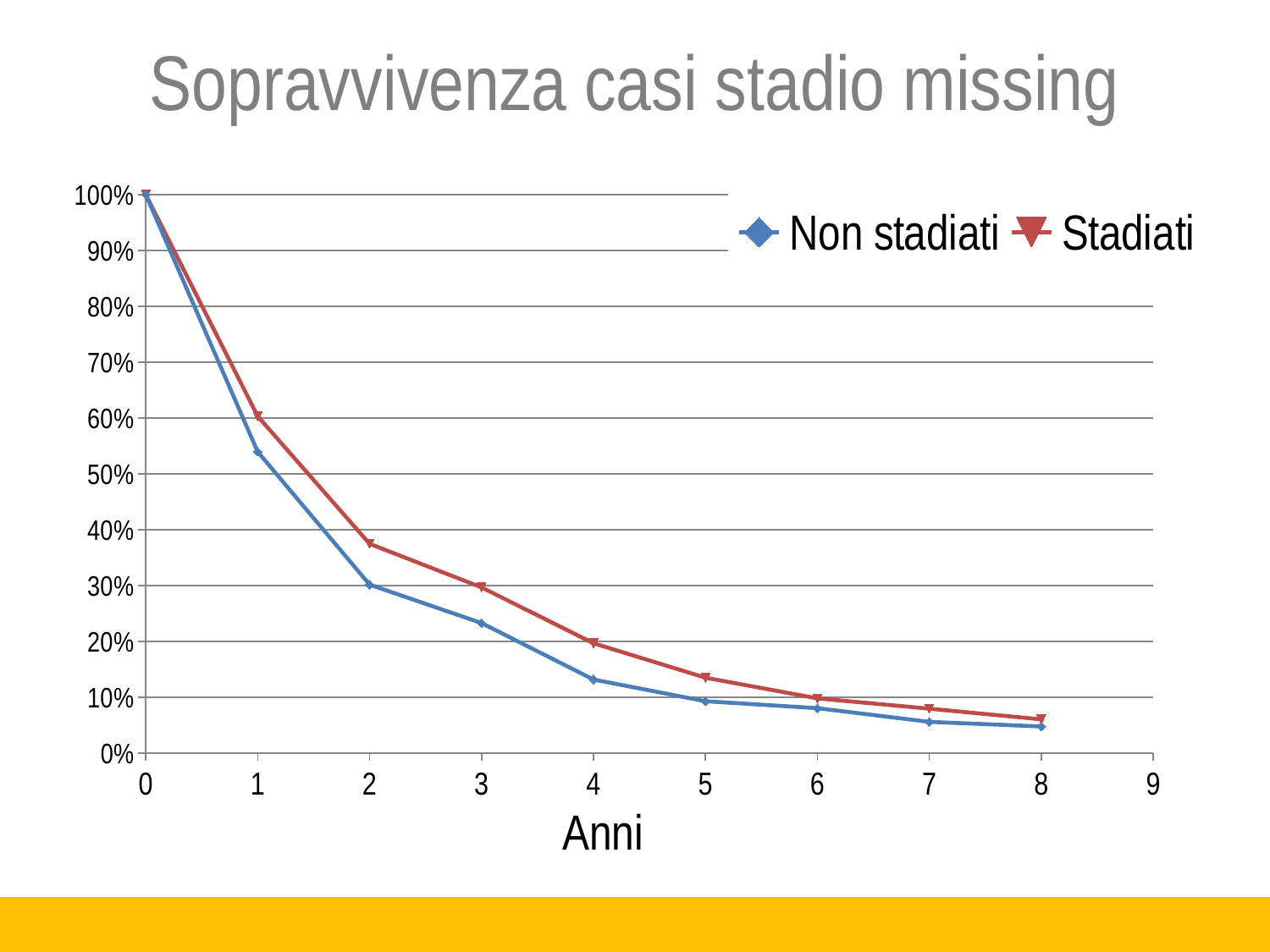
At year 2, which series has the higher value, Non stadiati or Stadiati? Stadiati What are the names of the two series in the legend? Non stadiati and Stadiati How many data points are plotted for the Non stadiati series? 9 Is the value for Non stadiati at year 1 greater or less than 50%? greater Is the value for Stadiati at year 2 greater or less than 40%? less Do the values of the Stadiati series rise or fall as the years increase? fall What is the value of the Stadiati series at year 0? 100% What is the title of the chart? Sopravvivenza casi stadio missing How many series does the legend list? 2 Is the value for Non stadiati at year 8 greater or less than 10%? less What is the value of the Non stadiati series at year 0? 100% What kind of chart is shown on the slide? line chart